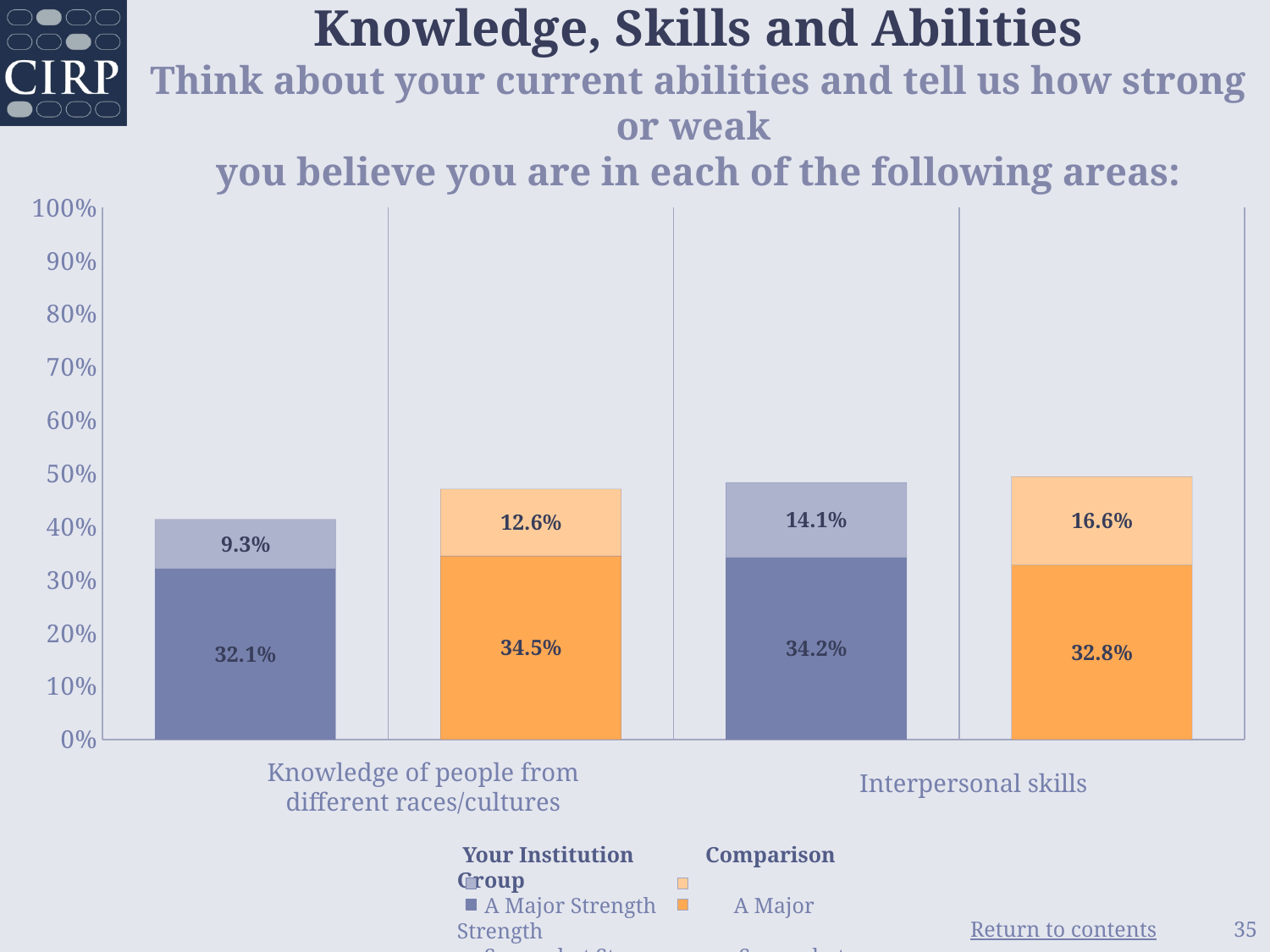
Which colour represents the Comparison Group in the chart? Orange What type of chart is shown on the slide? Stacked bar chart What is the value of the lighter top segment of the Your Institution bar for 'Knowledge of people from different races/cultures'? 9.3% What percentage of Your Institution respondents rated 'Knowledge of people from different races/cultures' as A Major Strength? 9.3% What is the difference between the Comparison Group and Your Institution 'A Major Strength' values for 'Knowledge of people from different races/cultures'? 3.3% How many categories are shown on the x axis? 2 What percentage of the Comparison Group rated 'Interpersonal skills' as A Major Strength? 16.6% What is the value of the lighter top segment of the Comparison Group bar for 'Interpersonal skills'? 16.6% What is the total height of the Comparison Group stacked bar for 'Interpersonal skills'? 49.4% Which of the four 'A Major Strength' values shown is the highest? 16.6% (Comparison Group, Interpersonal skills) For 'Interpersonal skills', which group has the larger 'A Major Strength' value, Your Institution or the Comparison Group? Comparison Group What is the total height of the Your Institution stacked bar for 'Knowledge of people from different races/cultures'? 41.4%